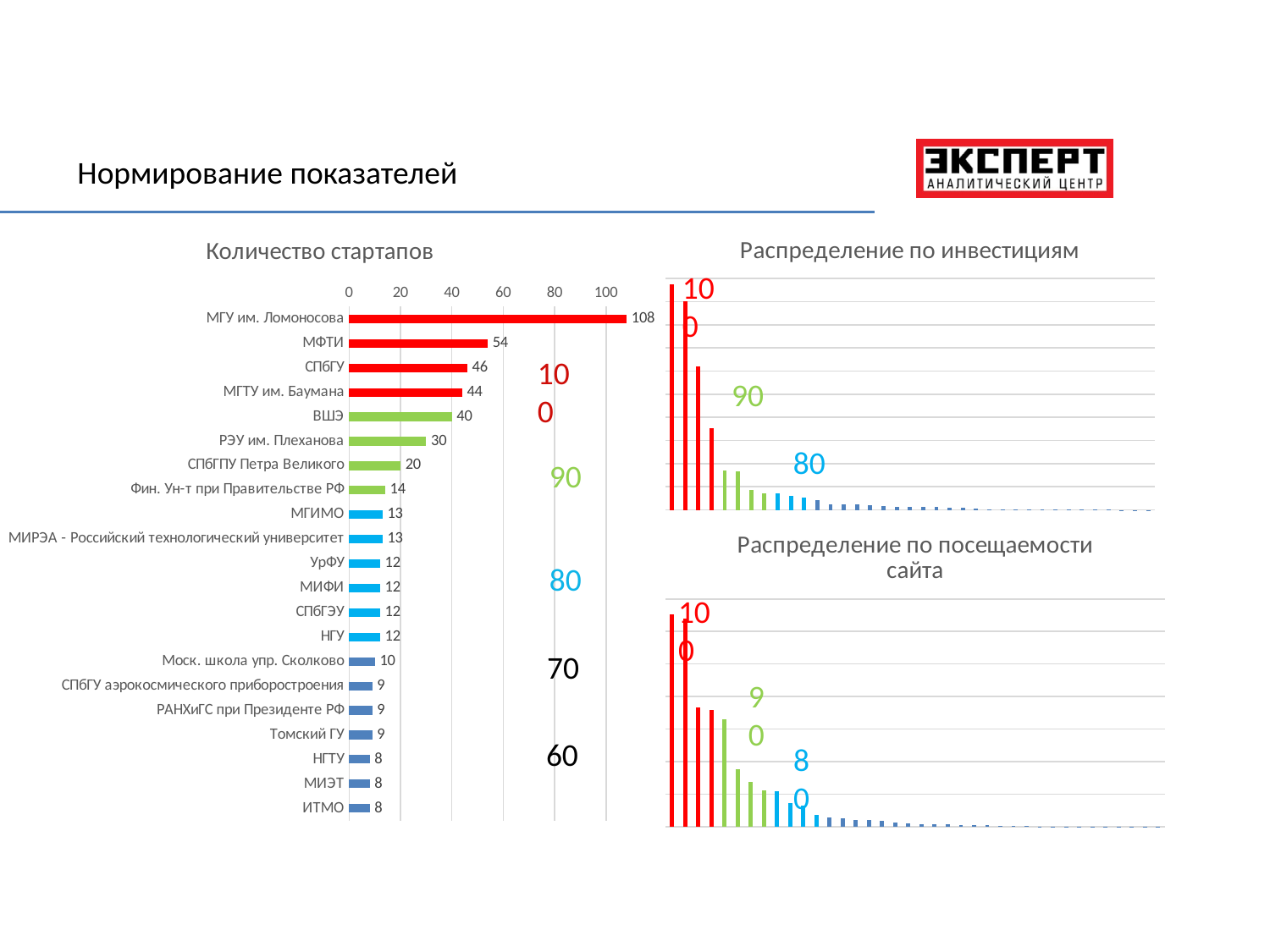
In the chart 'Количество стартапов', which category has the highest value? МГУ им. Ломоносова In the chart 'Количество стартапов', which is larger, the value for СПбГПУ Петра Великого or the value for Фин. Ун-т при Правительстве РФ? СПбГПУ Петра Великого In the chart 'Количество стартапов', what is the value for РЭУ им. Плеханова? 30 What is the title of the chart at the bottom right of the slide? Распределение по посещаемости сайта In the chart 'Количество стартапов', what is the value for ВШЭ? 40 In the chart 'Количество стартапов', what is the value for МГУ им. Ломоносова? 108 In the chart 'Количество стартапов', what is the difference between the values for МГУ им. Ломоносова and МФТИ? 54 How many categories are shown in the chart 'Количество стартапов'? 21 In the chart 'Количество стартапов', is the value for МФТИ greater or less than 60? less In the chart 'Количество стартапов', what is the difference between the values for СПбГУ and МГТУ им. Баумана? 2 What kind of chart is 'Количество стартапов'? Bar chart In the chart 'Количество стартапов', what is the value for Моск. школа упр. Сколково? 10